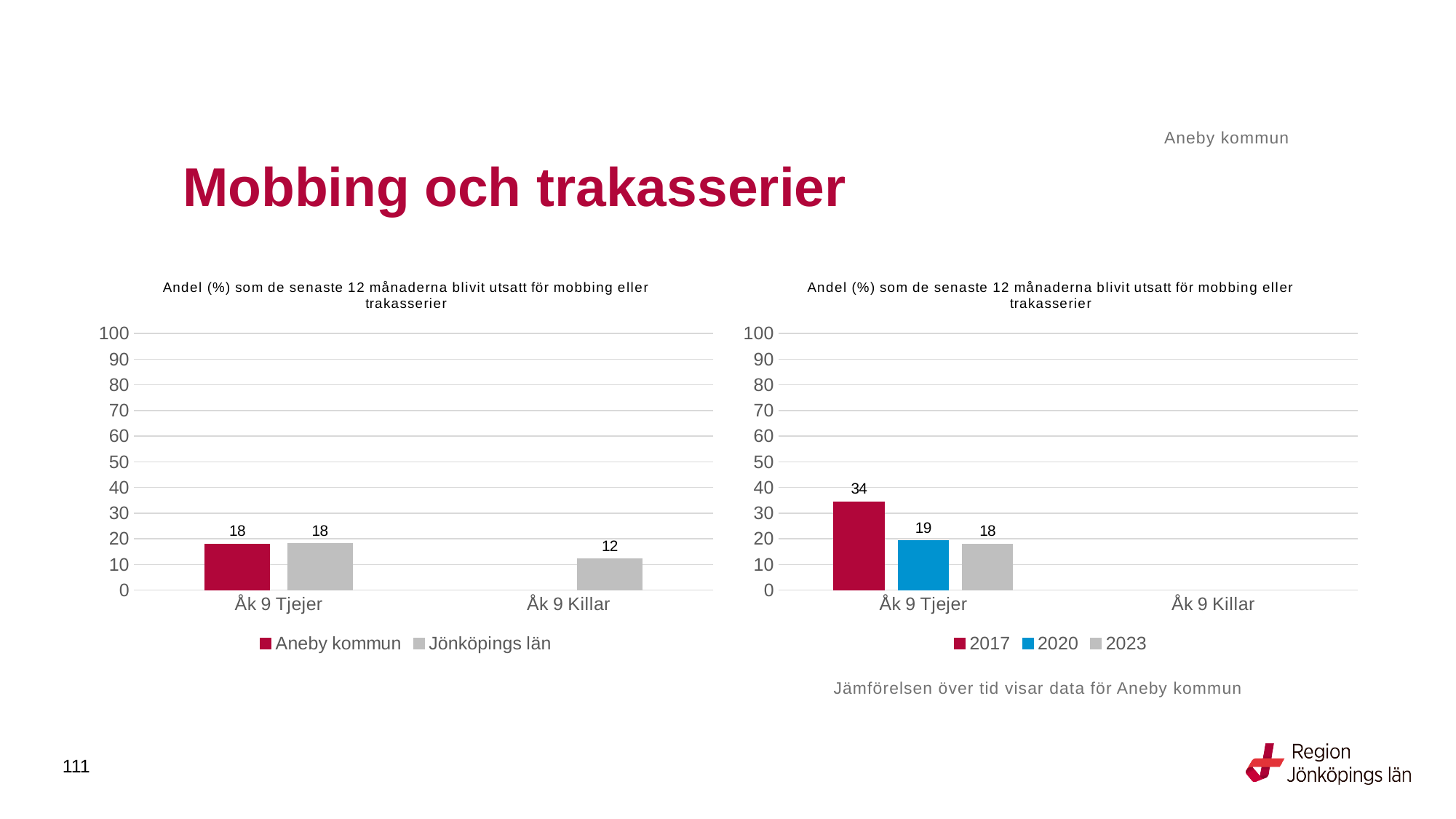
In the right chart, what is the value for 2017 for Åk 9 Tjejer? 34 In the right chart, what is the value for 2020 for Åk 9 Tjejer? 19 In the left chart, how many series does the legend list? 2 In the left chart, what is the difference between the Jönköpings län values for Åk 9 Tjejer and Åk 9 Killar? 6 In the right chart, do the values for Åk 9 Tjejer rise or fall from 2017 to 2023? fall What kind of chart is the right chart? bar chart In the left chart, what is the value for Aneby kommun for Åk 9 Tjejer? 18 In the left chart, is the Jönköpings län value for Åk 9 Killar greater or less than 20? less In the right chart, which year has the highest value for Åk 9 Tjejer? 2017 In the left chart, what is the value for Jönköpings län for Åk 9 Killar? 12 In the right chart, how many series does the legend list? 3 In the right chart, what is the difference between the 2017 and 2023 values for Åk 9 Tjejer? 16